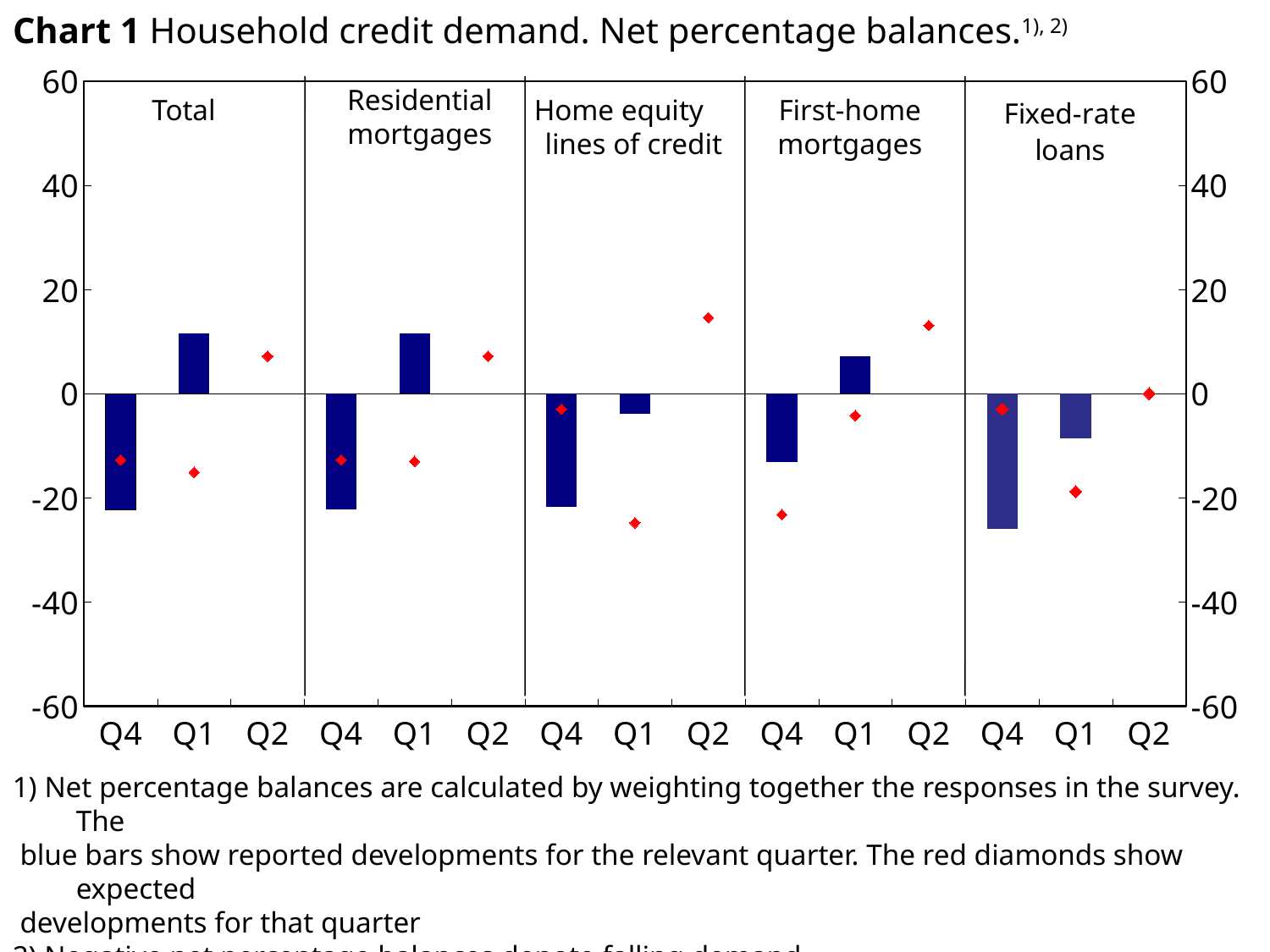
Which is higher, the Q1 bar for Home equity lines of credit or the Q1 bar for First-home mortgages? First-home mortgages According to the footnote, what do the red diamonds show? expected developments for that quarter What kind of chart is Chart 1? bar chart How many credit categories (panels) are shown in Chart 1? 5 Is the Q1 bar for Total greater or less than 0? greater Is the Q4 red diamond for First-home mortgages greater or less than -20? less Is the Q2 red diamond for Home equity lines of credit greater or less than 10? greater Do the Total bars rise or fall from Q4 to Q1? rise For Fixed-rate loans, which bar is lower, Q4 or Q1? Q4 Which category has the lowest Q4 bar? Fixed-rate loans